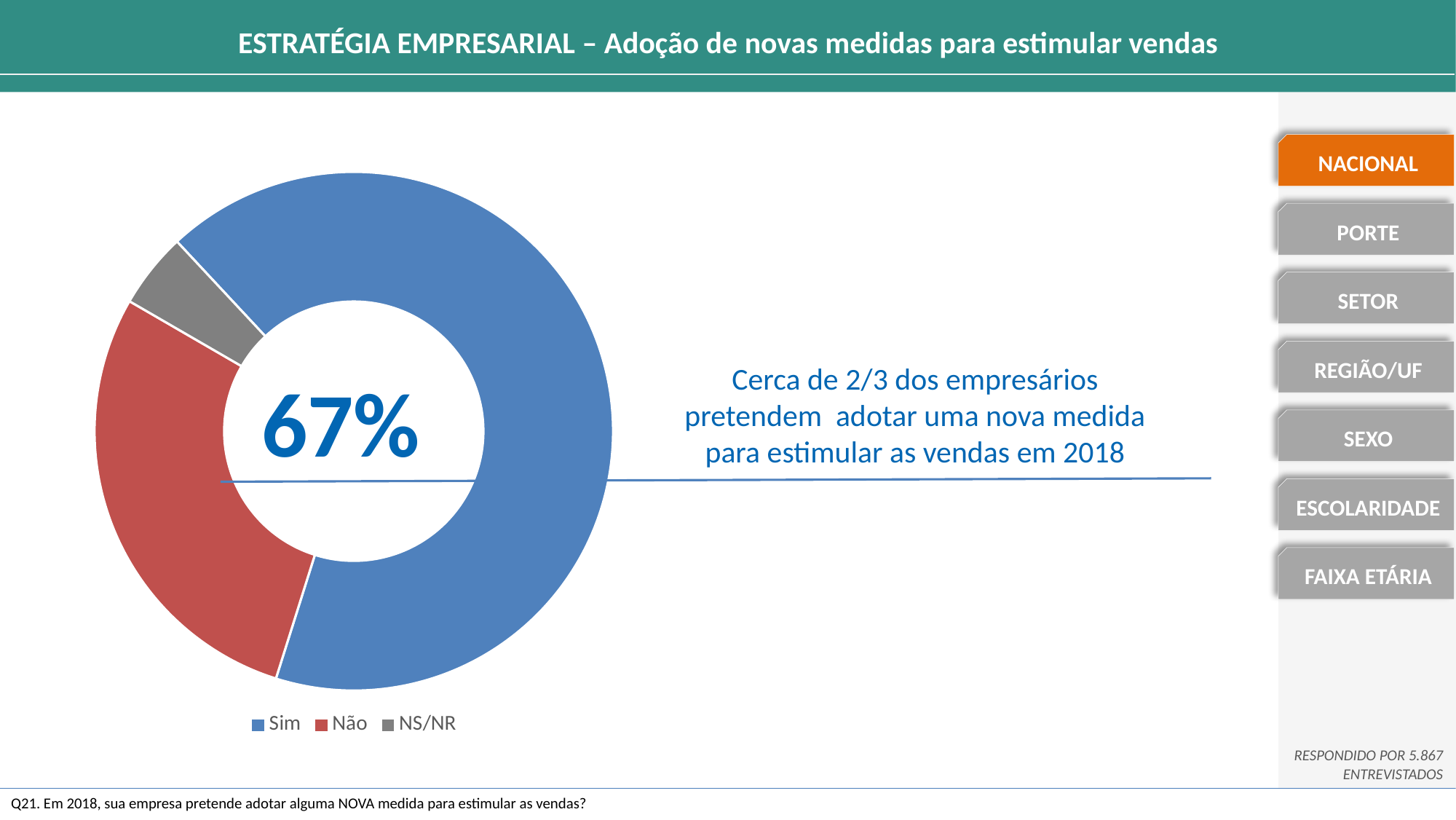
Which category has the smallest slice? NS/NR Which slice is larger, 'Não' or 'NS/NR'? Não How many categories does the chart show? 3 What colour is the 'Não' slice? red Is the share for 'Sim' greater or less than 50%? greater Which category has the largest slice? Sim What percentage is printed in the centre of the chart? 67% What are the legend entries, in order? Sim, Não, NS/NR How many entries does the legend list? 3 What share of the chart does the 'Sim' slice represent? 67% What kind of chart is shown on the slide? doughnut (pie) chart Which slice is larger, 'Sim' or 'Não'? Sim